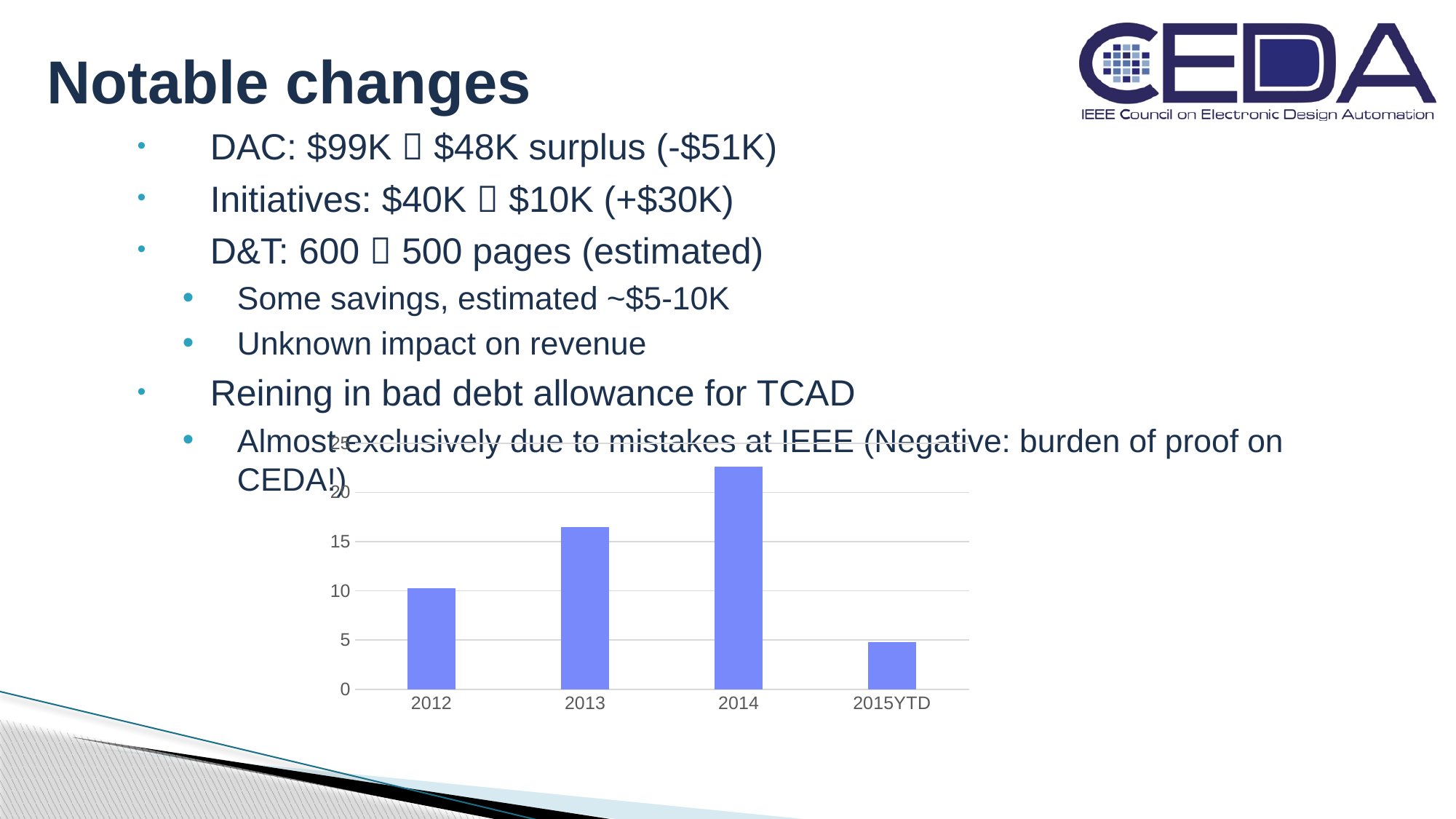
Do the values in the chart rise or fall from 2012 to 2014? rise What kind of chart is shown on the slide? bar chart What is the highest value shown on the chart's vertical axis? 25 Which category has the lowest bar in the chart? 2015YTD Which is larger in the chart, the value for 2015YTD or the value for 2014? 2014 Is the value for 2015YTD greater or less than 10? less Which category has the highest bar in the chart? 2014 Is the value for 2013 greater or less than 15? greater Is the value for 2012 greater or less than 15? less How many categories are shown on the x axis of the chart? 4 Which is larger in the chart, the value for 2013 or the value for 2012? 2013